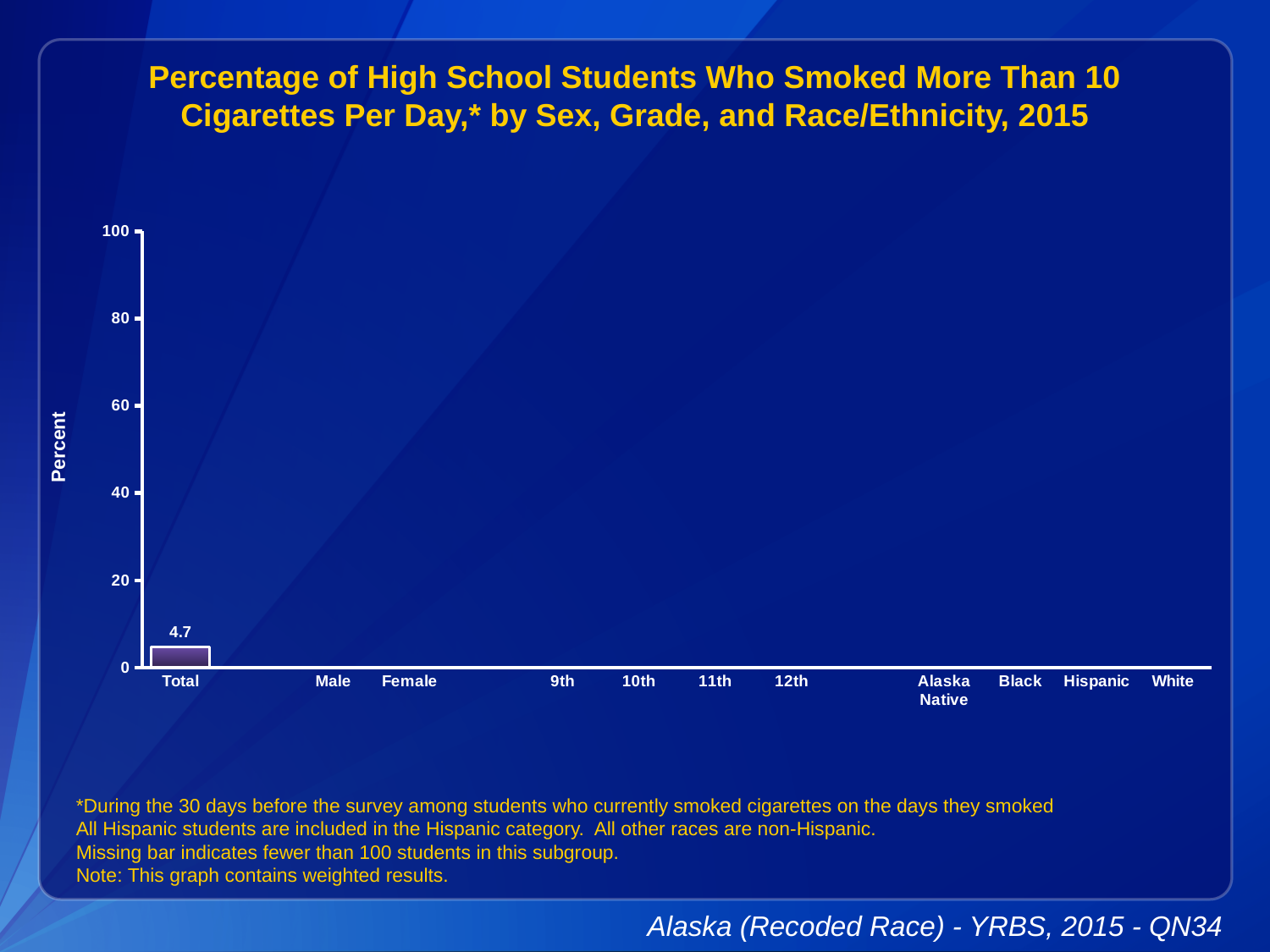
According to the note on the slide, what does a missing bar indicate? Fewer than 100 students in this subgroup How many category labels are shown along the x axis? 11 What is the value shown for the Total category? 4.7 What is the label on the y axis? Percent Which category is the only one with a plotted bar? Total How many bars are actually plotted on the chart? 1 What is the highest tick value shown on the y axis? 100 Is the value for Total greater or less than 20? less What kind of chart is shown on the slide? bar chart